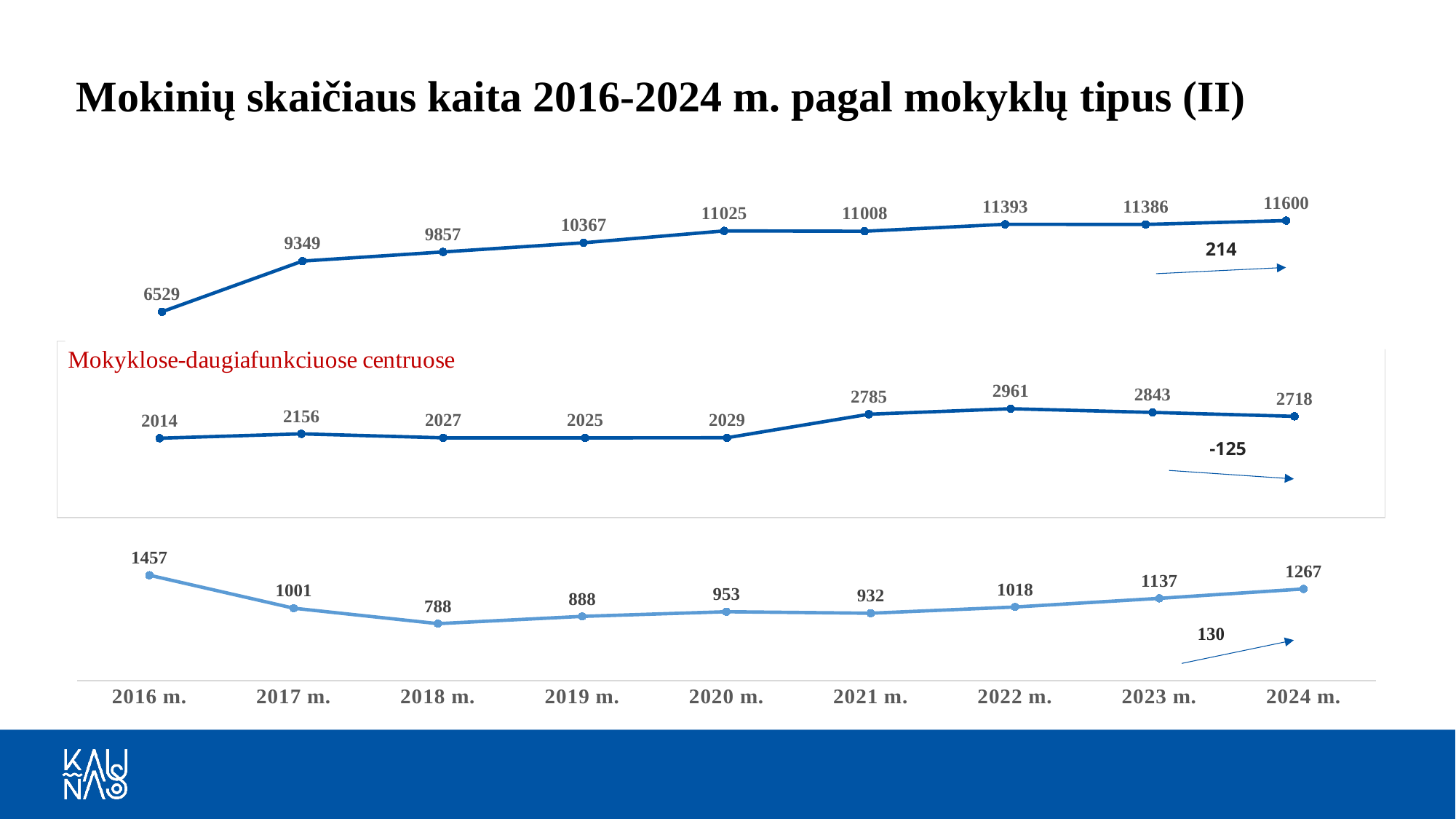
On the chart labelled Mokyklose-daugiafunkciuose centruose, by how much does the value for 2024 m. differ from the value for 2023 m.? 125 On the bottom line chart, what is the value for 2018 m.? 788 On the bottom line chart, which year has the lowest value? 2018 m. On the top line chart, do the values generally rise or fall from 2016 m. to 2024 m.? Rise On the bottom line chart, which is larger, the value for 2017 m. or the value for 2019 m.? 2017 m. How many years are shown on the x axis? 9 On the chart labelled Mokyklose-daugiafunkciuose centruose, what is the value for 2022 m.? 2961 What kind of chart is used on this slide? Line chart On the top line chart, what is the value for 2016 m.? 6529 On the top line chart, what is the difference between the values for 2024 m. and 2016 m.? 5071 On the bottom line chart, which year has the highest value? 2016 m. On the chart labelled Mokyklose-daugiafunkciuose centruose, which year has the highest value? 2022 m.